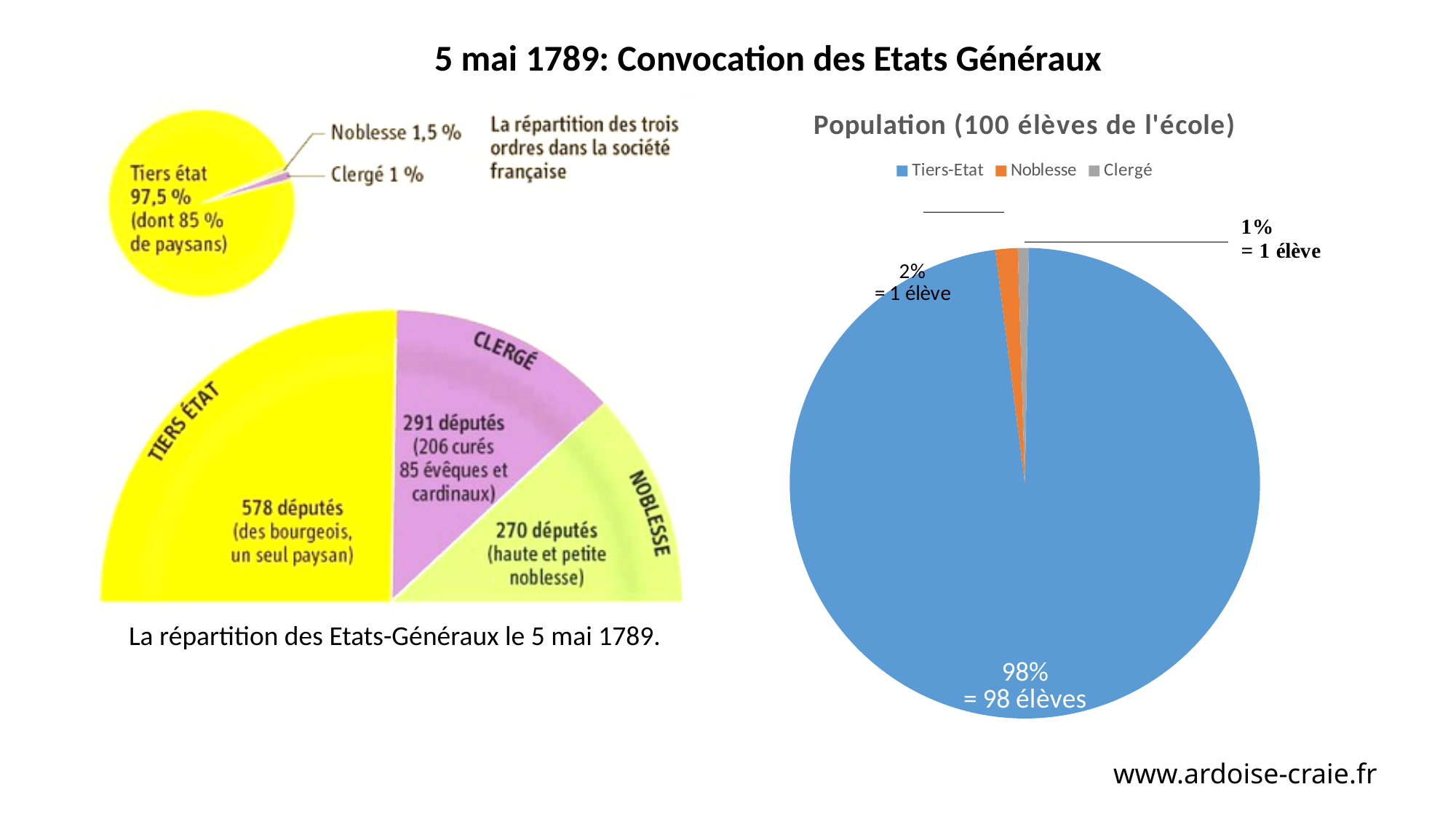
What kind of chart is the 'Population (100 élèves de l'école)' chart? pie chart In the half-circle chart 'La répartition des Etats-Généraux le 5 mai 1789', how many députés does the Clergé have? 291 députés In the small pie chart 'La répartition des trois ordres dans la société française', what percentage is shown for Noblesse? 1,5 % In the half-circle chart 'La répartition des Etats-Généraux le 5 mai 1789', what is the difference in députés between the Tiers état and the Noblesse? 308 How many entries does the legend of the 'Population (100 élèves de l'école)' chart list? 3 In the 'Population (100 élèves de l'école)' chart, which category has the largest slice? Tiers-Etat In the 'Population (100 élèves de l'école)' chart, what percentage is shown for Noblesse? 2% In the 'Population (100 élèves de l'école)' chart, what percentage is shown for Clergé? 1% In the small pie chart 'La répartition des trois ordres dans la société française', what percentage is shown for Tiers état? 97,5 % In the half-circle chart 'La répartition des Etats-Généraux le 5 mai 1789', which order has the fewest députés? Noblesse In the 'Population (100 élèves de l'école)' chart, what percentage is shown for Tiers-Etat? 98% In the 'Population (100 élèves de l'école)' chart, how many élèves does the Tiers-Etat slice represent? 98 élèves